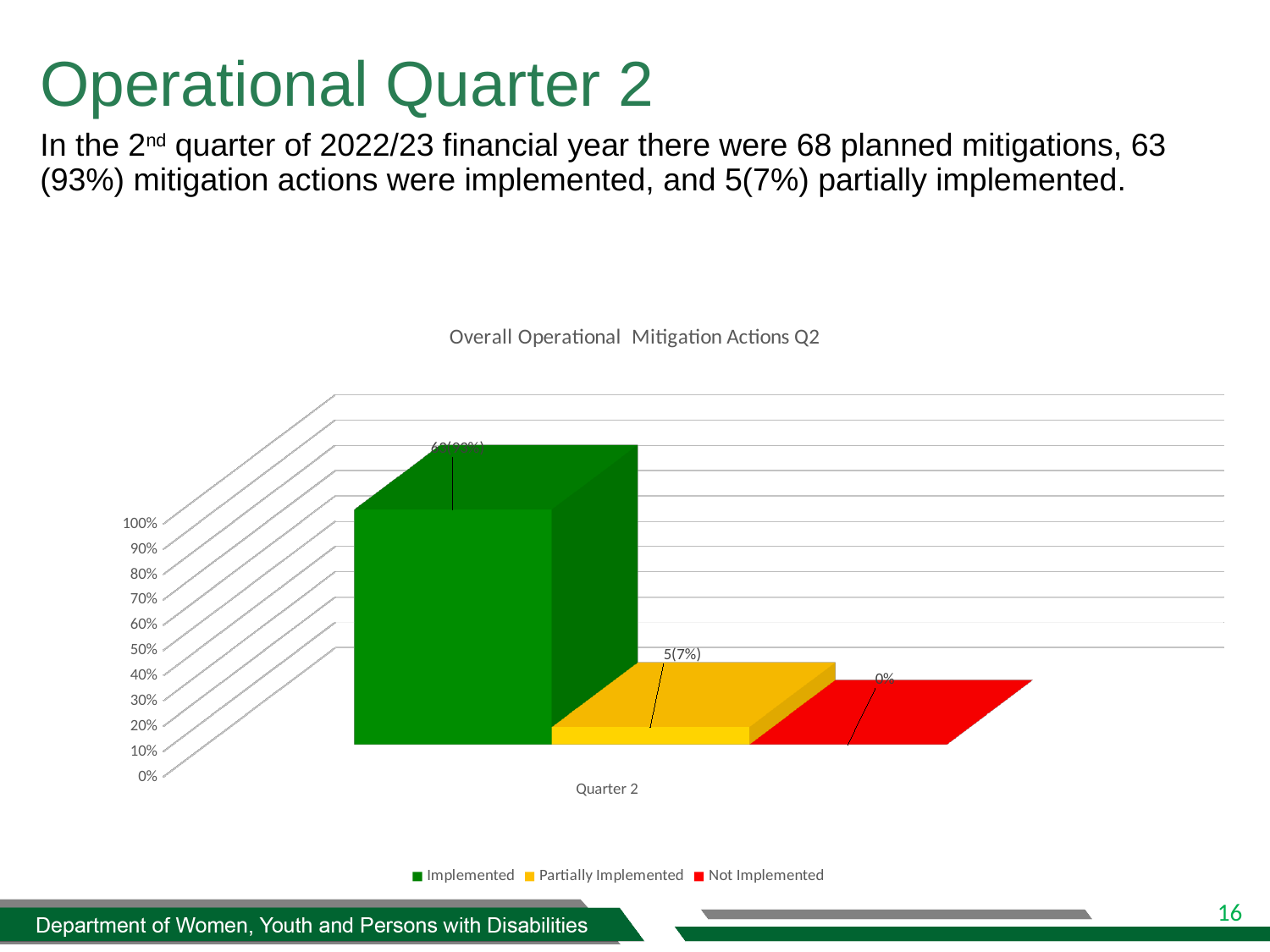
Which is larger in Quarter 2, Implemented or Partially Implemented? Implemented What is the title of the chart? Overall Operational Mitigation Actions Q2 Which is larger in Quarter 2, Partially Implemented or Not Implemented? Partially Implemented Which series has the highest value in Quarter 2? Implemented What is the data label shown for Partially Implemented in Quarter 2? 5(7%) What type of chart is shown on the slide? bar chart Which series has the lowest value in Quarter 2? Not Implemented Is the value for Partially Implemented in Quarter 2 greater or less than 50%? less What is the data label shown for Not Implemented in Quarter 2? 0% How many categories are shown on the x axis of the chart? 1 How many series does the chart legend list? 3 What category label appears on the x axis of the chart? Quarter 2